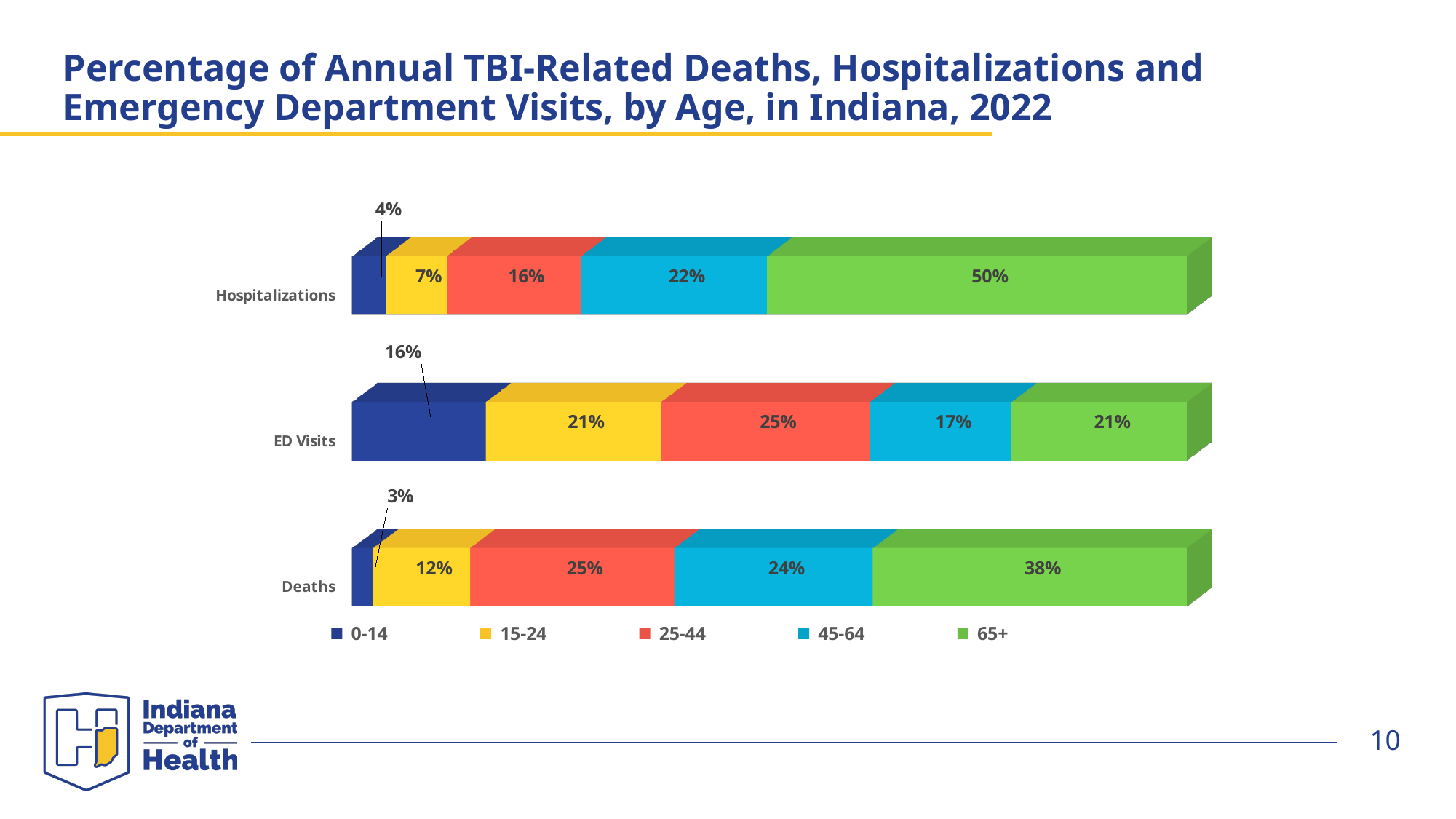
What percentage of TBI-related ED visits were among people aged 0-14? 16% Which age group accounts for the largest share of TBI-related hospitalizations? 65+ What is the difference between the 65+ share of hospitalizations and the 65+ share of deaths? 12% How many age groups does the legend list? 5 What percentage of TBI-related deaths were among people aged 15-24? 12% Which age group accounts for the smallest share of TBI-related deaths? 0-14 Which age group accounts for the largest share of TBI-related ED visits? 25-44 How many categories (outcome types) are shown on the chart? 3 What percentage of TBI-related hospitalizations were among people aged 65+? 50% What kind of chart is shown on the slide? Stacked bar chart Which is larger: the 0-14 share of ED visits or the 0-14 share of hospitalizations? ED Visits What percentage of TBI-related deaths were among people aged 45-64? 24%